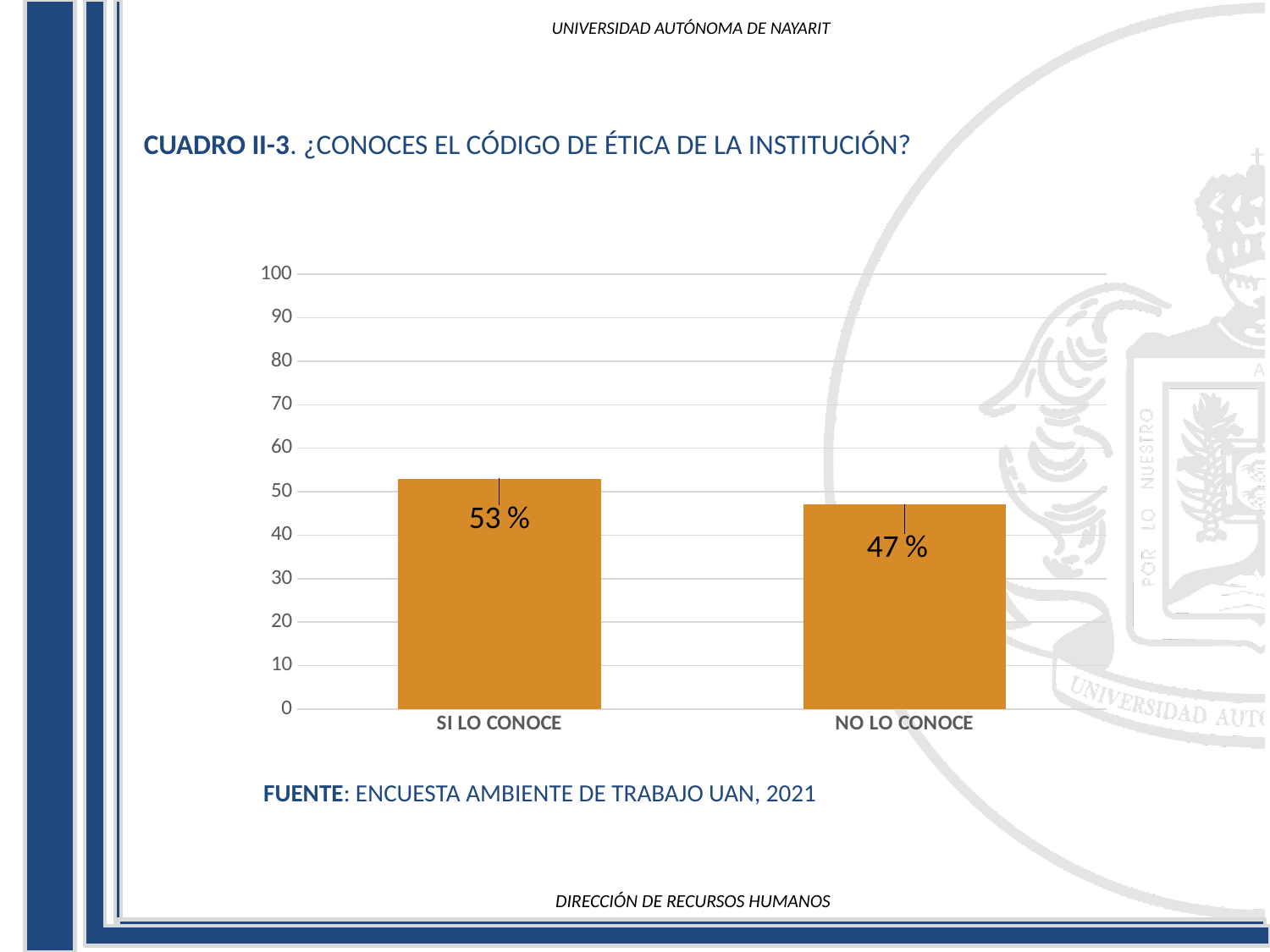
Which category has the lowest value? NO LO CONOCE How many categories are shown on the x axis? 2 What is the difference between the values for SI LO CONOCE and NO LO CONOCE? 6 % Is the value for SI LO CONOCE greater or less than 50? greater What is the value for SI LO CONOCE? 53 % Which is larger, the value for SI LO CONOCE or the value for NO LO CONOCE? SI LO CONOCE Is the value for NO LO CONOCE greater or less than 50? less What is the maximum value shown on the vertical axis? 100 What is the value for NO LO CONOCE? 47 % Which category has the highest value? SI LO CONOCE What kind of chart is shown on the slide? bar chart What is the source cited below the chart? ENCUESTA AMBIENTE DE TRABAJO UAN, 2021